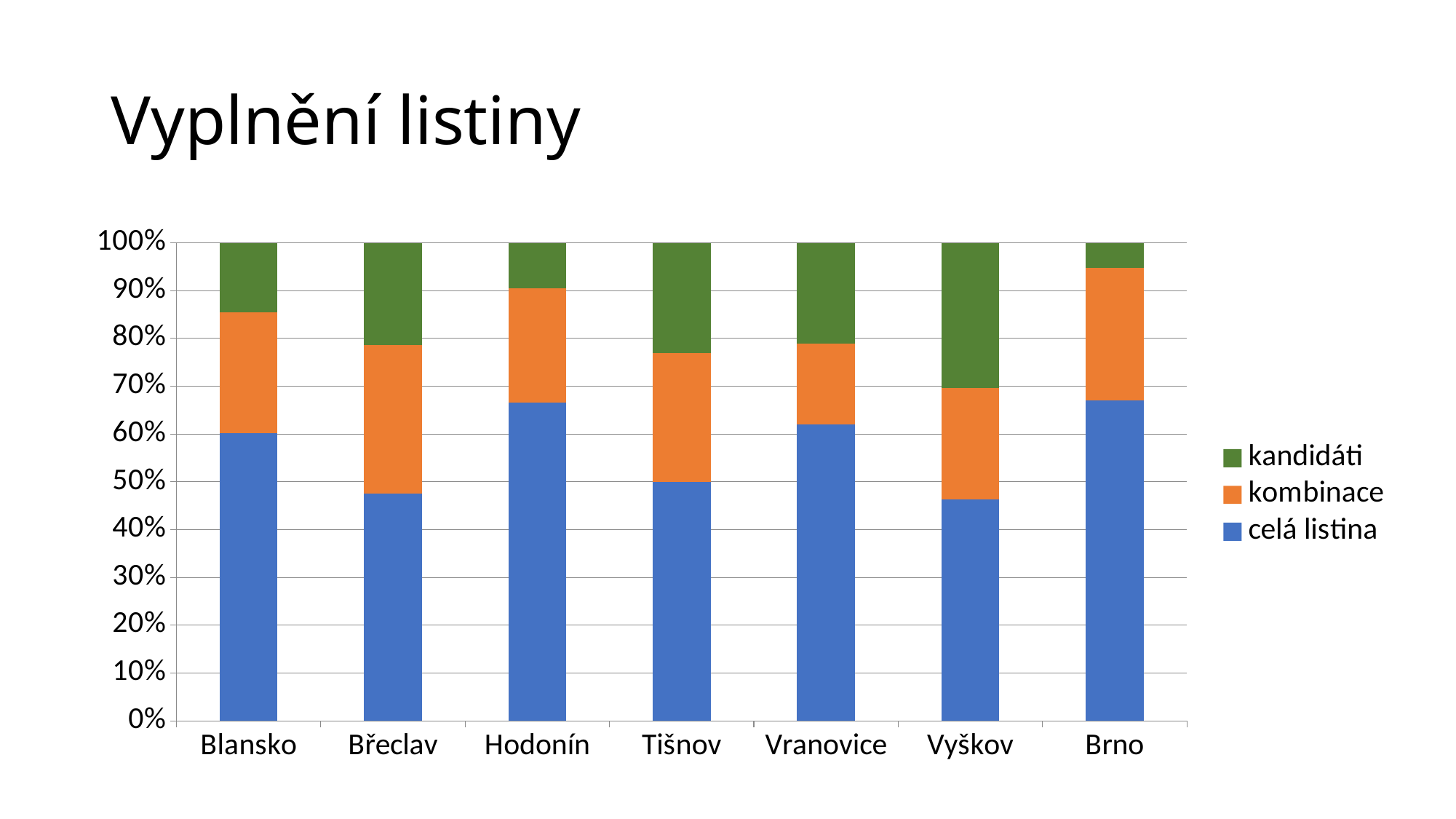
Which has a larger 'celá listina' segment, Hodonín or Tišnov? Hodonín What is the title of the chart? Vyplnění listiny Is the 'celá listina' value for Vyškov greater or less than 50%? less Which category has the largest 'kandidáti' segment? Vyškov Which category has the smallest 'kombinace' segment? Vranovice Is the 'celá listina' value for Hodonín greater or less than 60%? greater What is the total height of the stacked bar for Blansko? 100% How many series does the legend list? 3 How many categories are shown on the x axis? 7 Which colour represents the 'kandidáti' series in the legend? green Which category has the smallest 'kandidáti' segment? Brno What kind of chart is shown on the slide? stacked bar chart